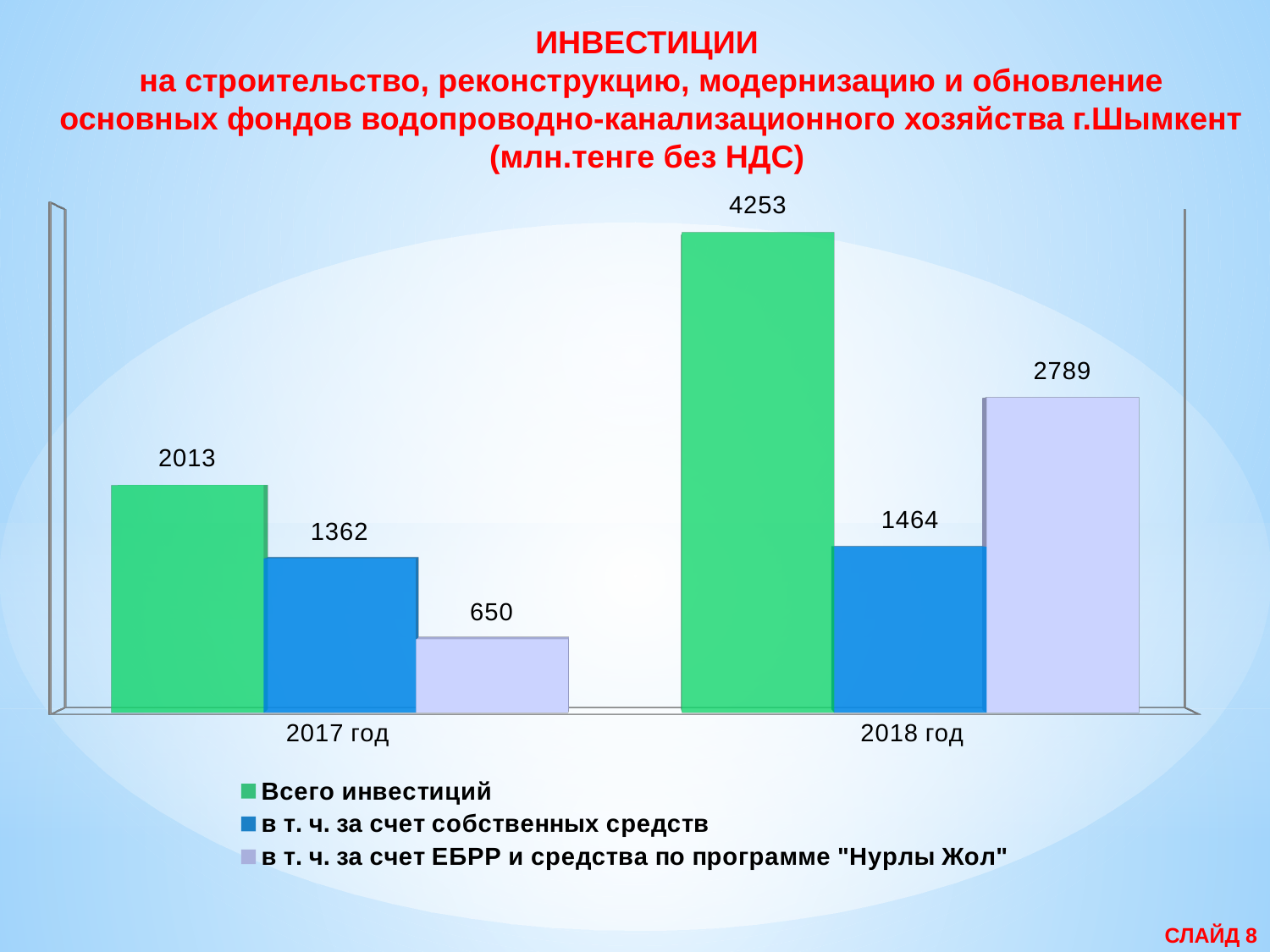
What is the difference between "в т. ч. за счет ЕБРР и средства по программе "Нурлы Жол"" in 2018 год and in 2017 год? 2139 What is the value of "в т. ч. за счет собственных средств" for 2018 год? 1464 How many year categories are shown on the x axis? 2 What is the value of "Всего инвестиций" for 2017 год? 2013 What is the difference between "Всего инвестиций" in 2018 год and in 2017 год? 2240 Which is larger in 2018 год: "в т. ч. за счет собственных средств" or "в т. ч. за счет ЕБРР и средства по программе "Нурлы Жол""? в т. ч. за счет ЕБРР и средства по программе "Нурлы Жол" What is the value of "в т. ч. за счет ЕБРР и средства по программе "Нурлы Жол"" for 2017 год? 650 How many series does the legend list? 3 Which year has the higher value for "Всего инвестиций"? 2018 год Which series has the lowest value in 2017 год? в т. ч. за счет ЕБРР и средства по программе "Нурлы Жол" Does the value of "в т. ч. за счет собственных средств" rise or fall from 2017 год to 2018 год? Rise What kind of chart is shown on the slide? Bar chart